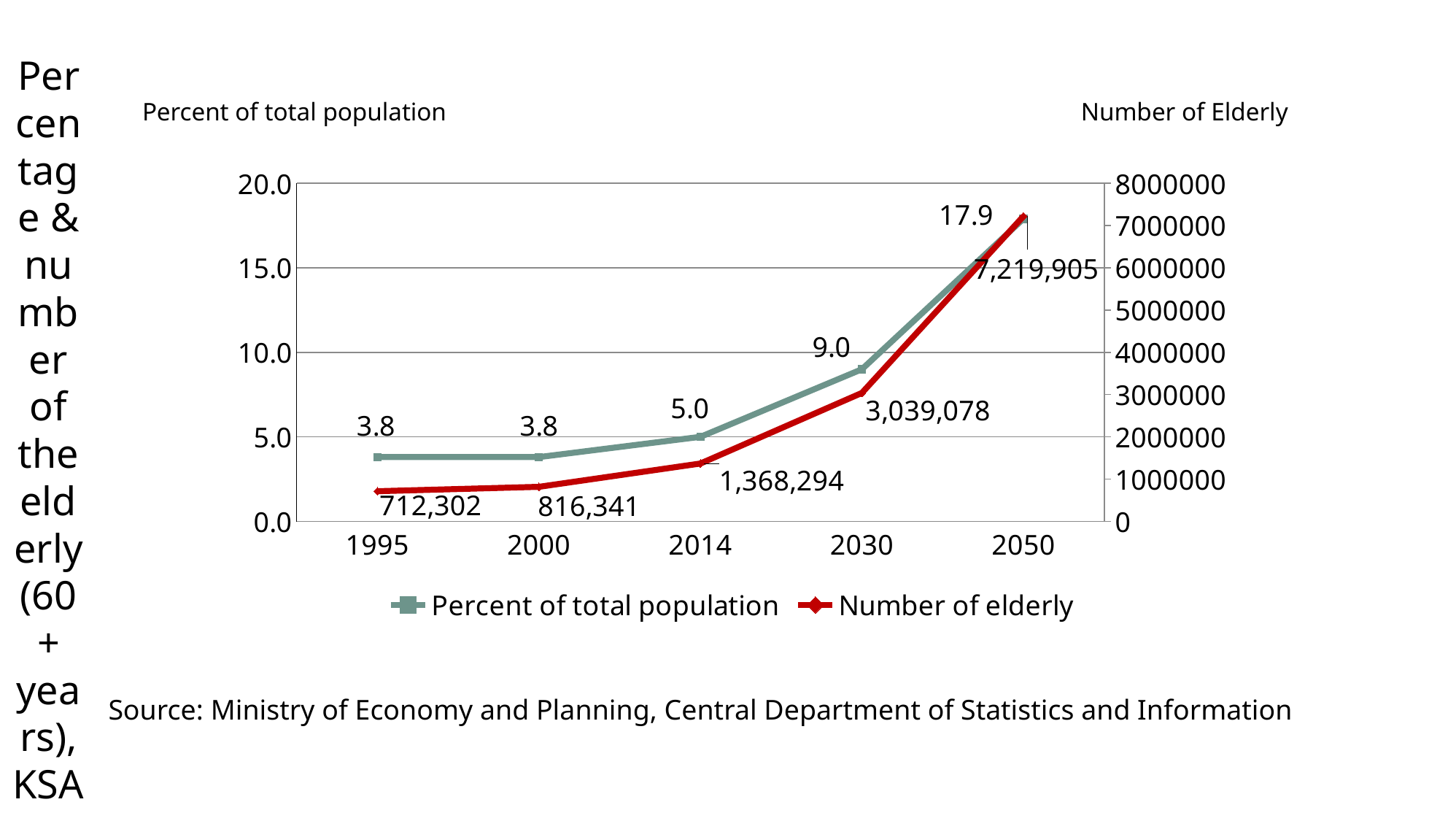
What is the percent of total population value for 2050? 17.9 What is the difference in percent of total population between 2050 and 2030? 8.9 How many years are shown on the x axis? 5 What is the number of elderly in 2030? 3,039,078 How many series does the legend list? 2 Which is larger, the number of elderly in 2014 or in 2030? 2030 What is the number of elderly in 1995? 712,302 What is the percent of total population value for 2014? 5.0 What kind of chart is this? Line chart Which year has the highest number of elderly? 2050 Which year has the lowest number of elderly? 1995 What is the difference in the number of elderly between 2000 and 1995? 104,039